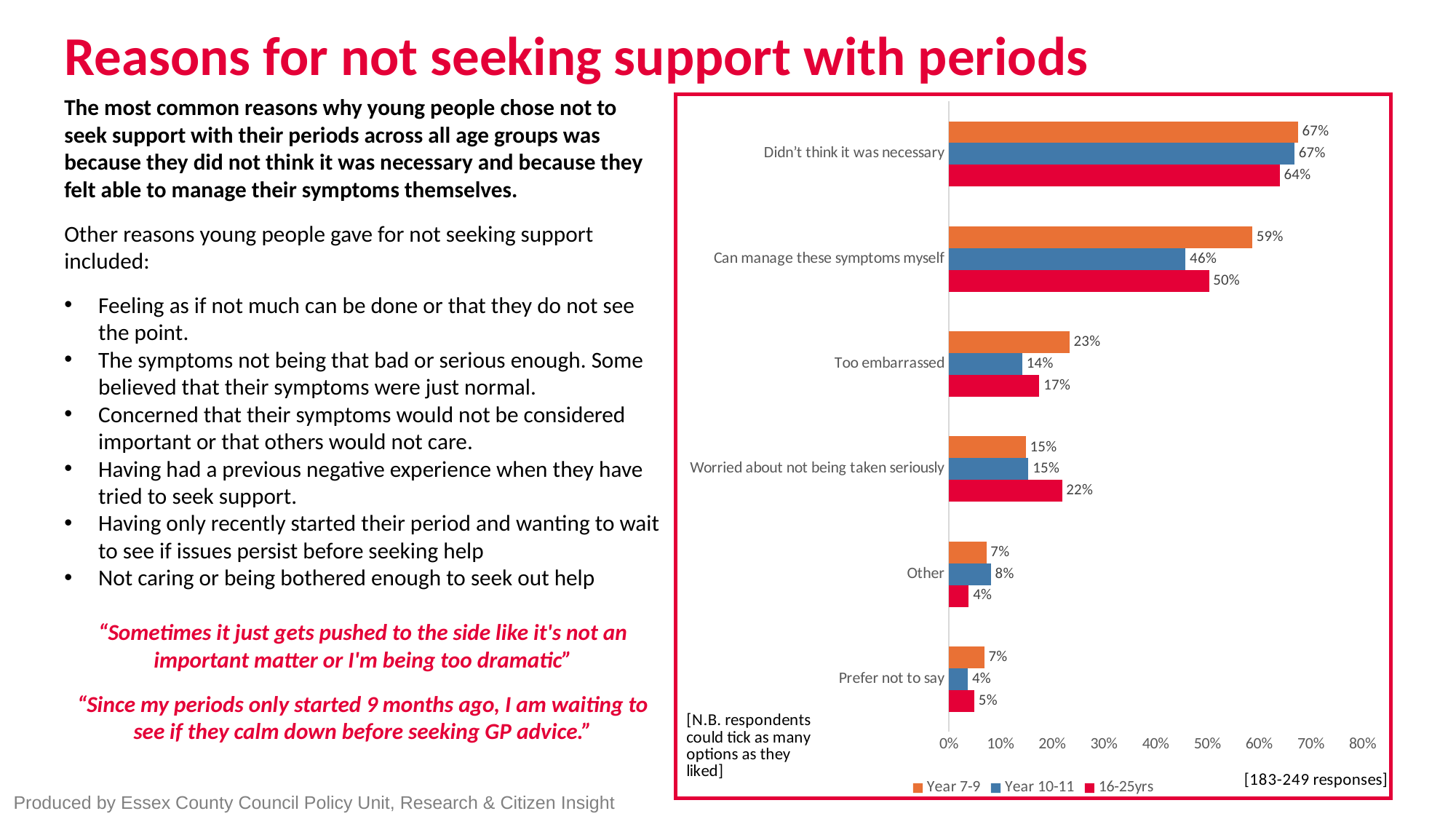
What is the value for Year 10-11 for 'Too embarrassed'? 14% How many reason categories are plotted on the chart? 6 For 'Too embarrassed', which is larger: the Year 7-9 value or the 16-25yrs value? Year 7-9 Is the Year 7-9 value for 'Didn't think it was necessary' greater or less than 60%? greater Which category has the highest value for the 16-25yrs series? Didn't think it was necessary What is the value for Year 7-9 for 'Can manage these symptoms myself'? 59% What is the difference between the Year 7-9 and Year 10-11 values for 'Can manage these symptoms myself'? 13% How many series does the chart legend list? 3 Which colour represents the 16-25yrs series in the chart? Red What is the value for 16-25yrs for 'Worried about not being taken seriously'? 22% Which category has the lowest value for the Year 10-11 series? Prefer not to say What kind of chart is shown on the slide? Bar chart